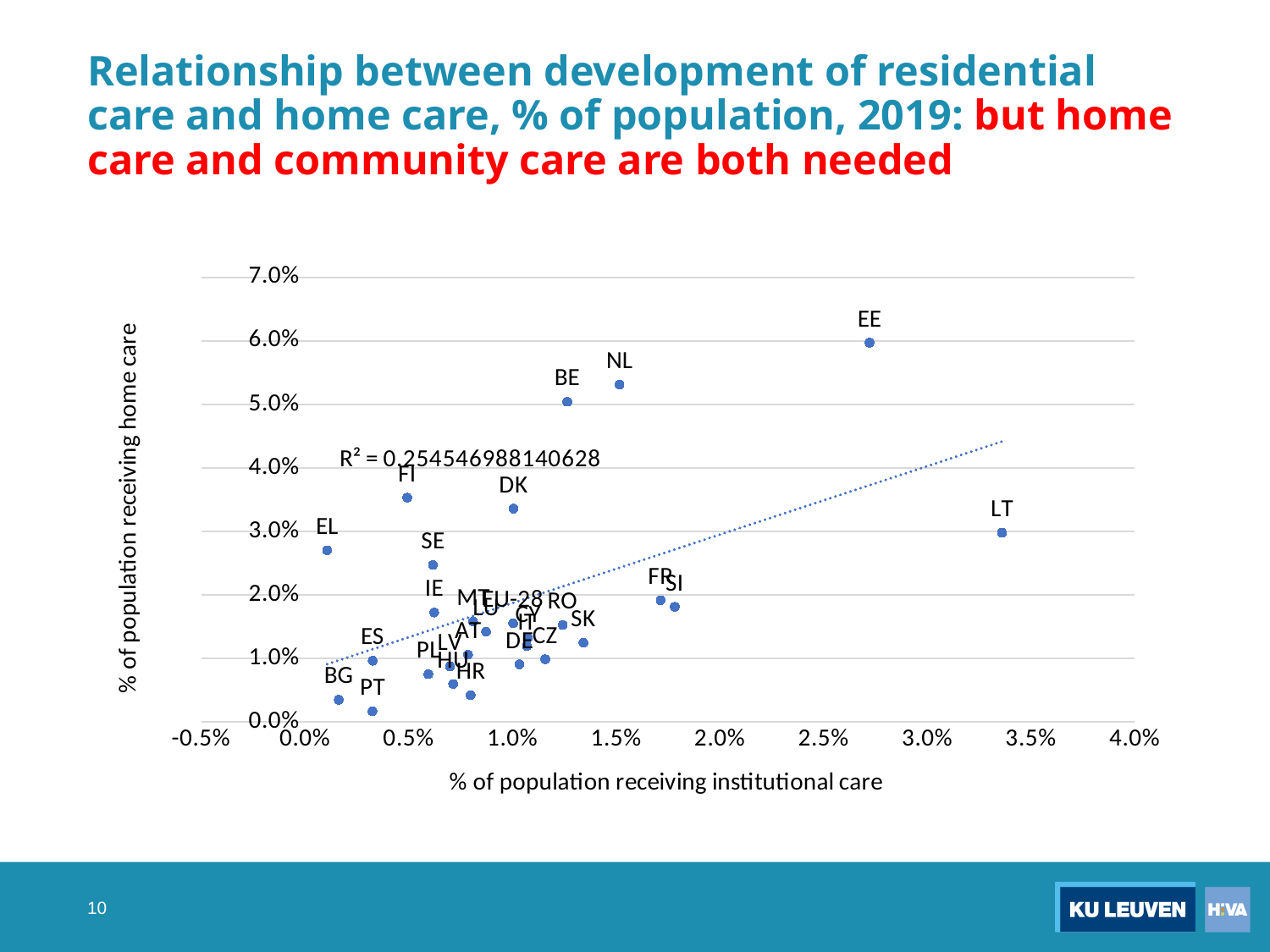
Which country has the highest % of population receiving home care? EE Is the % of population receiving home care for PT greater or less than 1.0%? less Which country has the highest % of population receiving institutional care? LT What R² value is printed on the chart? R² = 0.254546988140628 Which has a higher % of population receiving home care, NL or BE? NL Is the % of population receiving institutional care for EL greater or less than 0.5%? less Which country has the lowest % of population receiving home care? PT Is the % of population receiving home care for EE greater or less than 5.0%? greater What kind of chart is shown on the slide? scatter chart Does the dotted trend line rise or fall as % of population receiving institutional care increases? rises